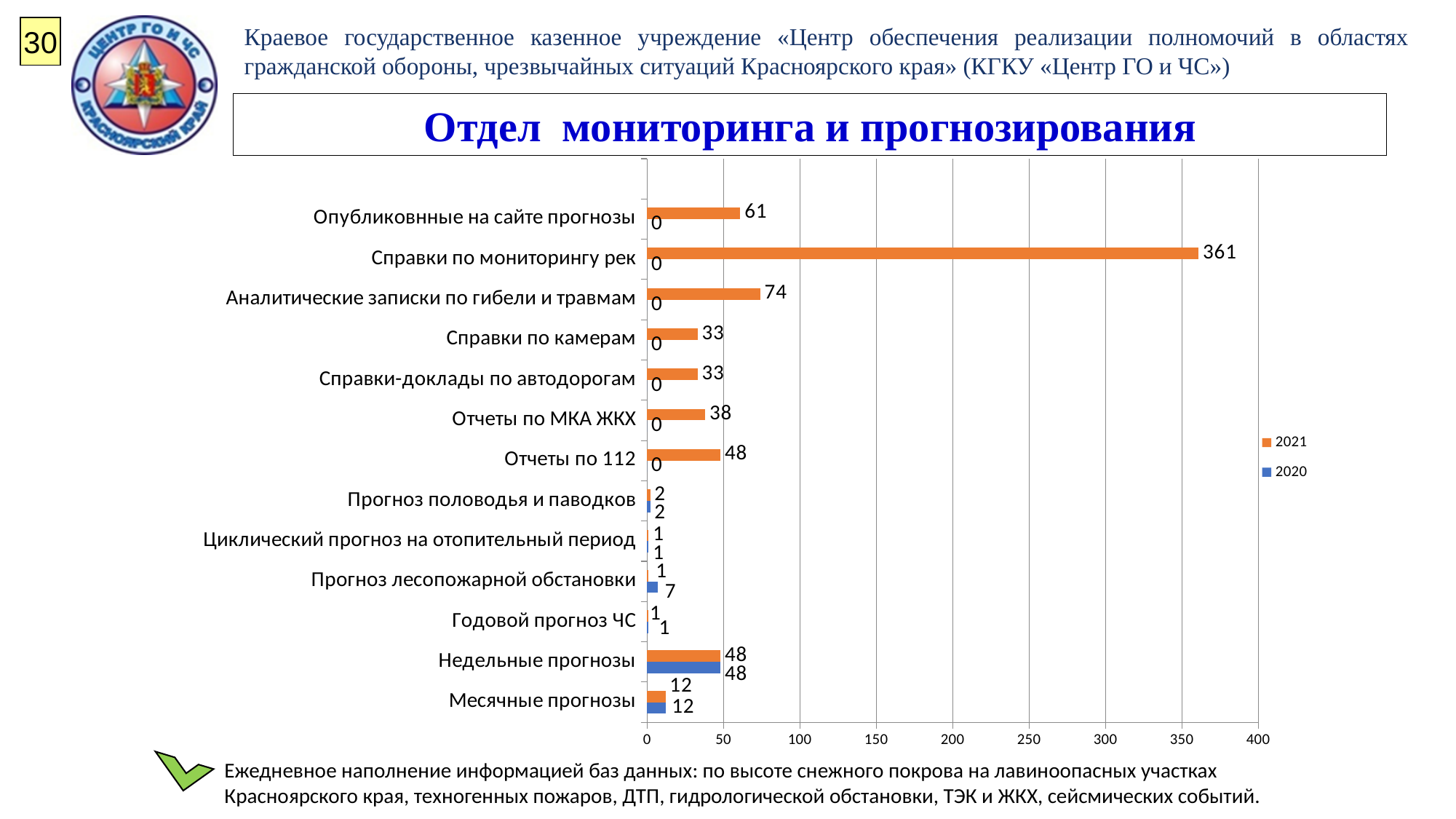
What is the 2021 value for Справки по мониторингу рек? 361 Which category has the highest 2020 value? Недельные прогнозы What is the 2020 value for Прогноз лесопожарной обстановки? 7 Which category has the highest 2021 value? Справки по мониторингу рек How many categories are shown on the chart? 13 Which is larger for Прогноз лесопожарной обстановки: the 2021 value or the 2020 value? 2020 How many series does the legend list? 2 What kind of chart is shown on the slide? bar chart What is the difference between the 2021 values for Опубликовнные на сайте прогнозы and Отчеты по 112? 13 What is the 2021 value for Отчеты по МКА ЖКХ? 38 Which colour represents the 2021 series in the chart? orange What is the 2021 value for Аналитические записки по гибели и травмам? 74